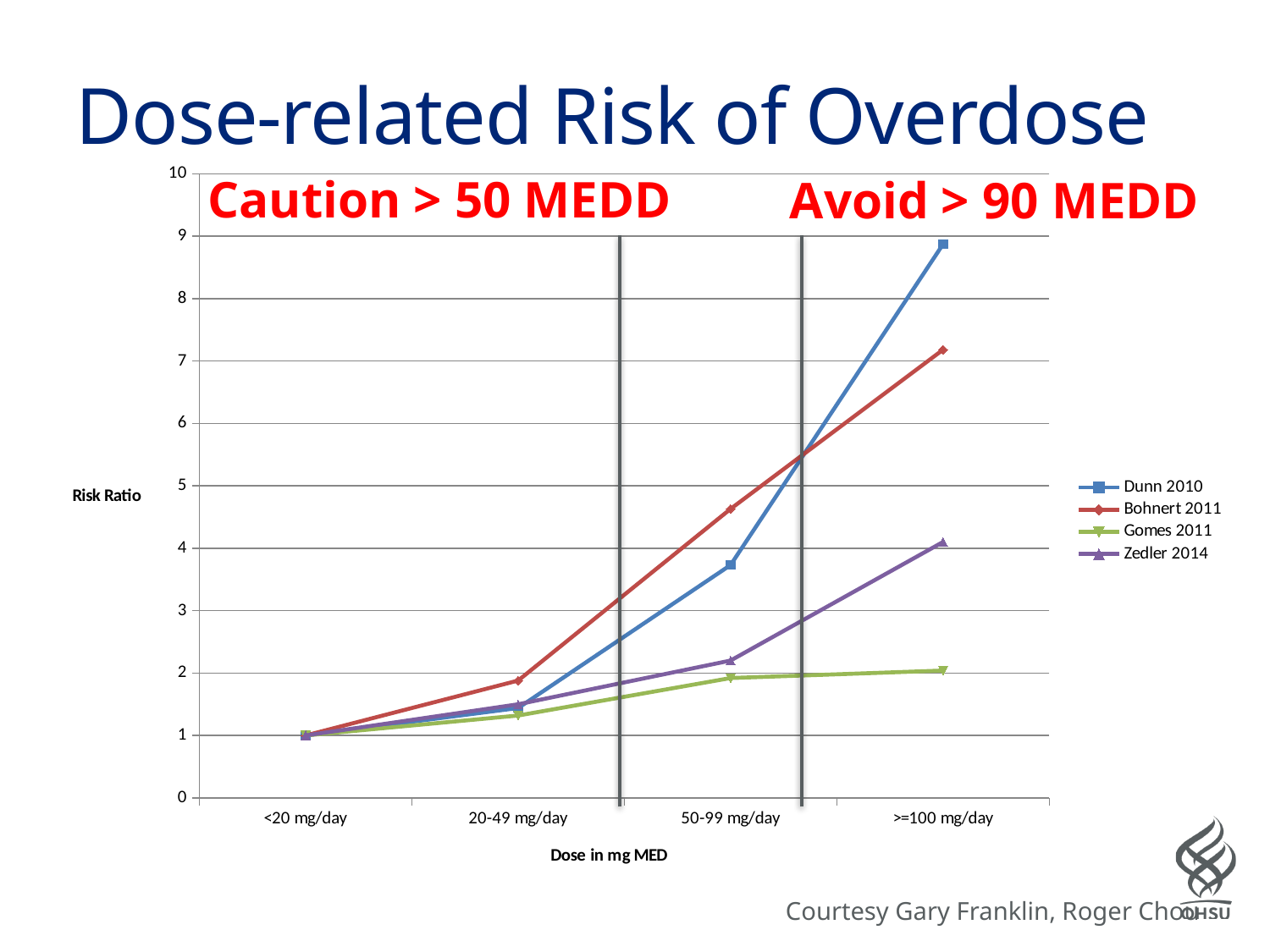
Is the risk ratio for Gomes 2011 at >=100 mg/day greater or less than 3? less At 50-99 mg/day, which series has the larger risk ratio, Bohnert 2011 or Dunn 2010? Bohnert 2011 Which series has the highest risk ratio at >=100 mg/day? Dunn 2010 What is the title of the chart? Dose-related Risk of Overdose Does the risk ratio for Dunn 2010 rise or fall as the dose increases along the x axis? rise Which series has the lowest risk ratio at >=100 mg/day? Gomes 2011 Is the risk ratio for Dunn 2010 at >=100 mg/day greater or less than 8? greater Is the risk ratio for Bohnert 2011 at 50-99 mg/day greater or less than 4? greater How many series does the legend list? 4 What kind of chart is shown on the slide? line chart What is the label of the y axis? Risk Ratio How many dose categories are shown on the x axis? 4